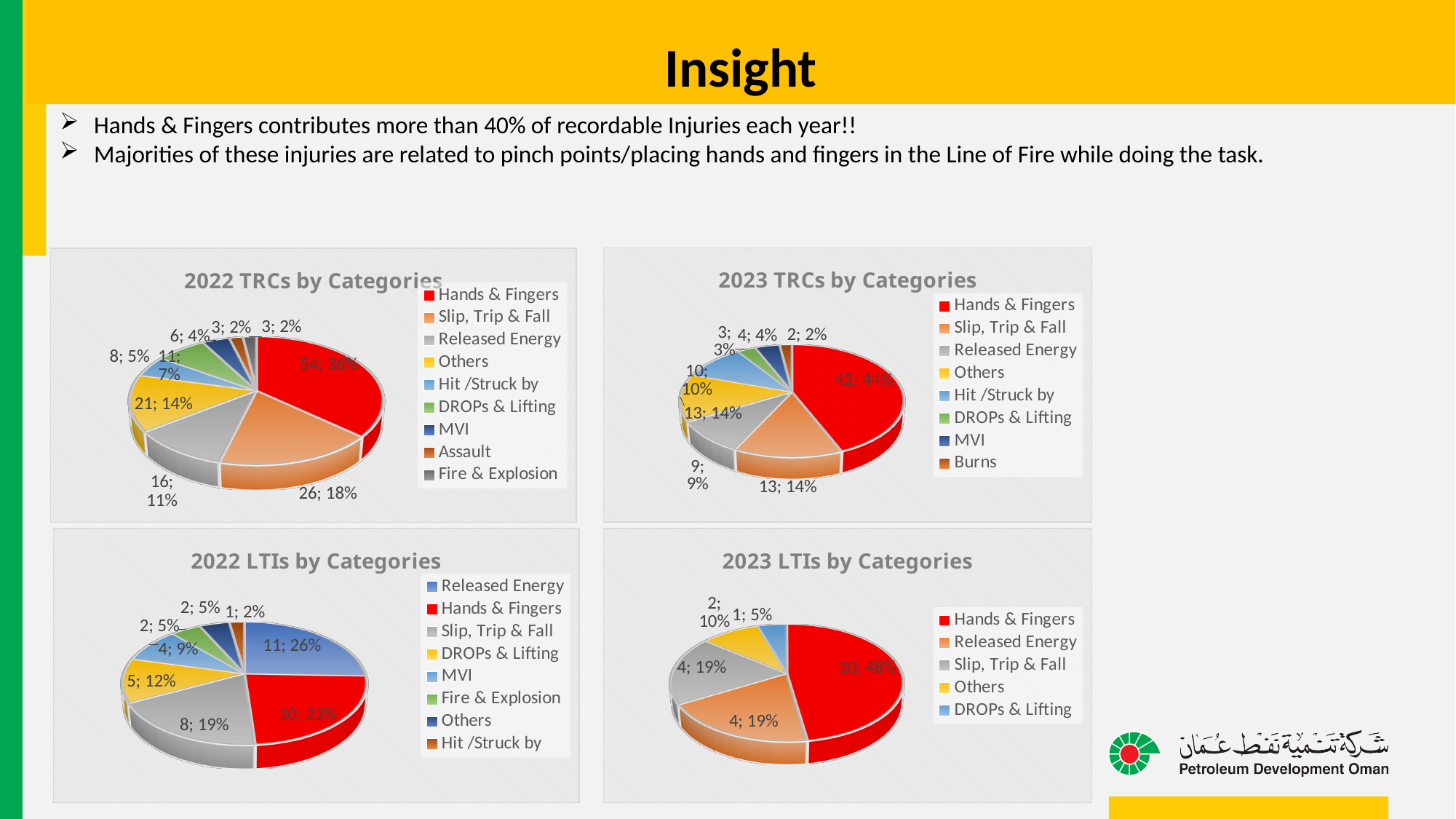
In the 2022 LTIs by Categories chart, which category has the largest slice? Released Energy How many categories does the legend of the 2022 TRCs by Categories chart list? 9 In the 2023 TRCs by Categories chart, what share of the pie does Hands & Fingers represent? 44% In the 2022 TRCs by Categories chart, what is the value and share for Hands & Fingers? 54; 36% In the 2022 LTIs by Categories chart, what is the value and share for Slip, Trip & Fall? 8; 19% In the 2022 TRCs by Categories chart, which category has the largest slice? Hands & Fingers What type of chart is the 2023 LTIs by Categories chart? Pie chart In the 2023 TRCs by Categories chart, which is larger: Hit /Struck by or Burns? Hit /Struck by In the 2023 LTIs by Categories chart, what share of the pie does Hands & Fingers represent? 48% How many categories does the legend of the 2023 LTIs by Categories chart list? 5 In the 2022 TRCs by Categories chart, what is the difference in count between Hands & Fingers (54) and Slip, Trip & Fall (26)? 28 In the 2023 TRCs by Categories chart, what is the value and share for Burns? 2; 2%